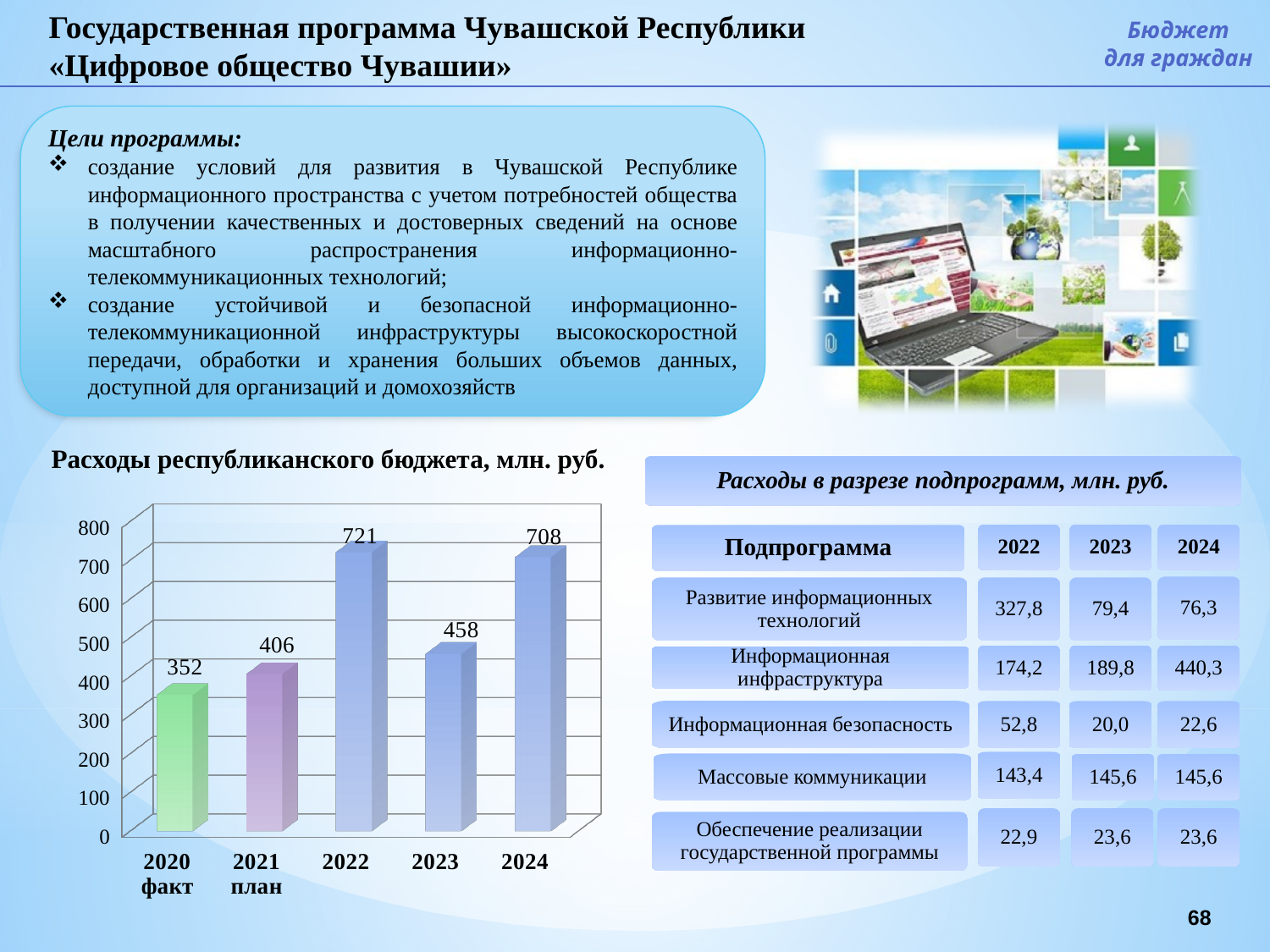
What is the value for 2023 in the chart "Расходы республиканского бюджета, млн. руб."? 458 What is the value for 2022 in the chart "Расходы республиканского бюджета, млн. руб."? 721 What is the title of the chart on the lower left of the slide? Расходы республиканского бюджета, млн. руб. How many bars are shown in the chart "Расходы республиканского бюджета, млн. руб."? 5 Is the value for 2024 in the chart "Расходы республиканского бюджета, млн. руб." greater or less than 600? greater What is the value for 2020 факт in the chart "Расходы республиканского бюджета, млн. руб."? 352 Which year has the highest value in the chart "Расходы республиканского бюджета, млн. руб."? 2022 Which is larger in the chart "Расходы республиканского бюджета, млн. руб.": the value for 2024 or the value for 2023? 2024 What is the difference between the values for 2022 and 2023 in the chart "Расходы республиканского бюджета, млн. руб."? 263 What kind of chart is "Расходы республиканского бюджета, млн. руб."? bar chart Which year has the lowest value in the chart "Расходы республиканского бюджета, млн. руб."? 2020 факт What is the difference between the values for 2021 план and 2020 факт in the chart "Расходы республиканского бюджета, млн. руб."? 54